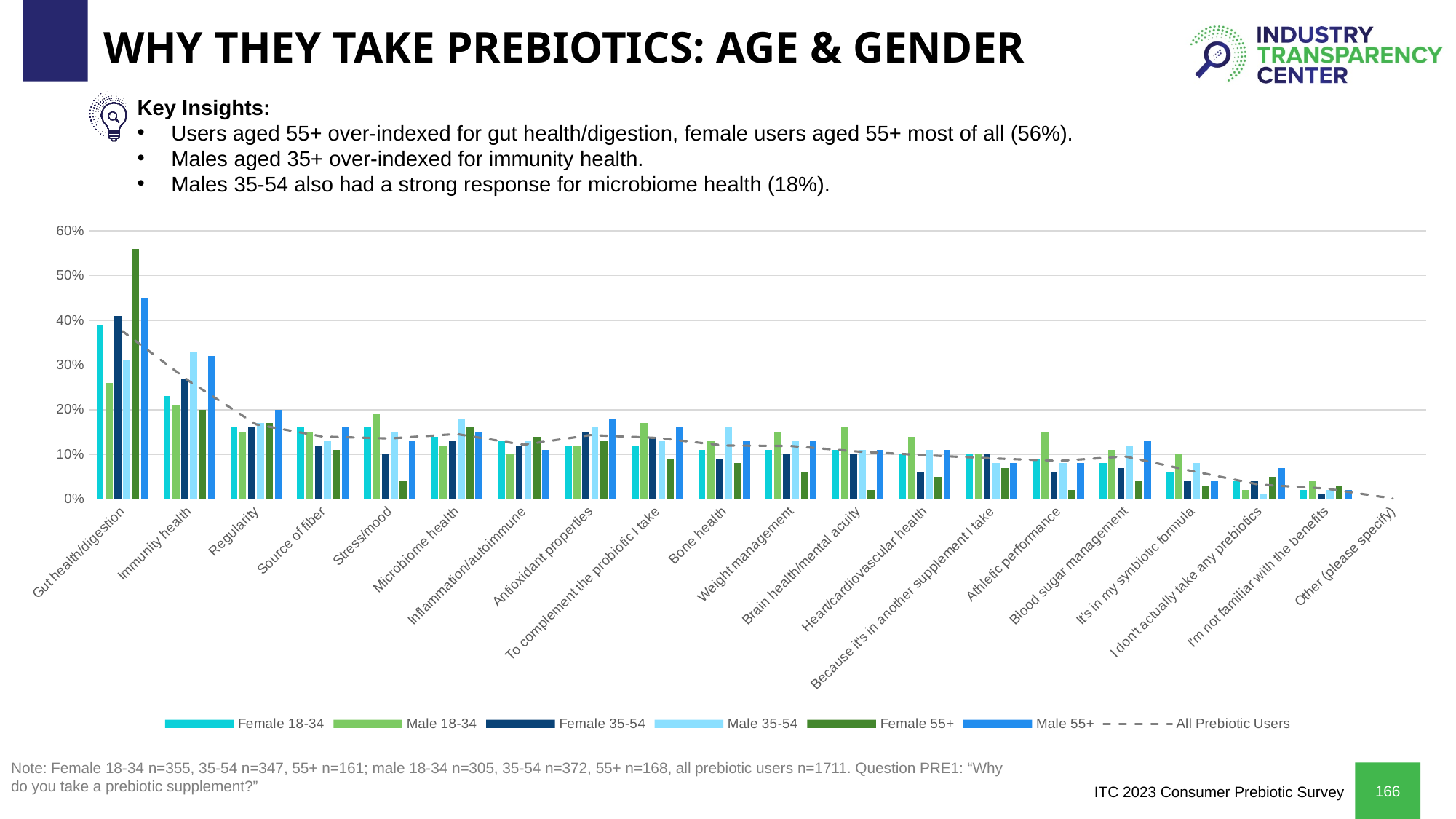
How many categories (reasons) are shown along the x axis of the chart? 20 Which series has the highest value for Gut health/digestion? Female 55+ For Gut health/digestion, which is larger: Female 18-34 or Male 18-34? Female 18-34 Is the value for Female 55+ for Stress/mood greater or less than 10%? less How many entries does the chart's legend list? 7 Is the value for Male 55+ for Gut health/digestion greater or less than 40%? greater Is the value for Male 35-54 for Immunity health greater or less than 30%? greater Which series has the lowest value for Gut health/digestion? Male 18-34 What kind of chart is shown on the slide? combination bar and line chart What is the value for Female 55+ for Gut health/digestion? 56% Does the dashed All Prebiotic Users line generally rise or fall from left to right along the x axis? fall Which category has the highest bars overall in the chart? Gut health/digestion